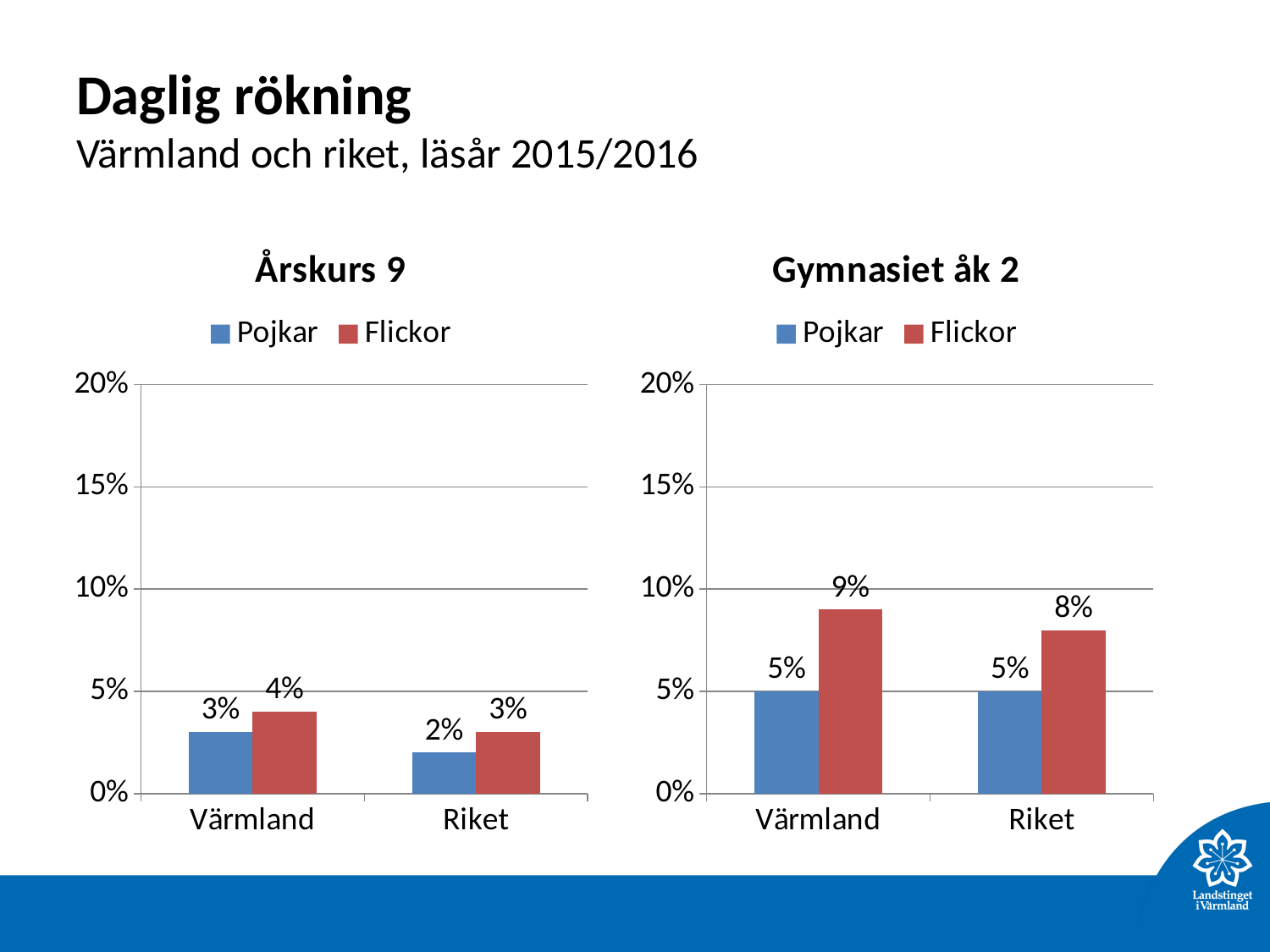
What kind of chart is the 'Gymnasiet åk 2' chart? Bar chart In the 'Gymnasiet åk 2' chart, which bar is the highest? Flickor, Värmland In the 'Årskurs 9' chart, what is the value for Pojkar in Värmland? 3% In the 'Årskurs 9' chart, which bar is the lowest? Pojkar, Riket In the 'Gymnasiet åk 2' chart, what is the difference between Flickor and Pojkar in Värmland? 4% In the 'Gymnasiet åk 2' chart, is the value for Flickor in Riket greater or less than 10%? less In the 'Årskurs 9' chart, what is the value for Flickor in Riket? 3% In the 'Gymnasiet åk 2' chart, what is the value for Pojkar in Riket? 5% In the 'Gymnasiet åk 2' chart, what is the value for Flickor in Värmland? 9% In the 'Årskurs 9' chart, what is the difference between Flickor in Värmland and Flickor in Riket? 1% In the 'Gymnasiet åk 2' chart, which is larger: Flickor in Värmland or Flickor in Riket? Flickor in Värmland How many series does the legend of the 'Årskurs 9' chart list? 2